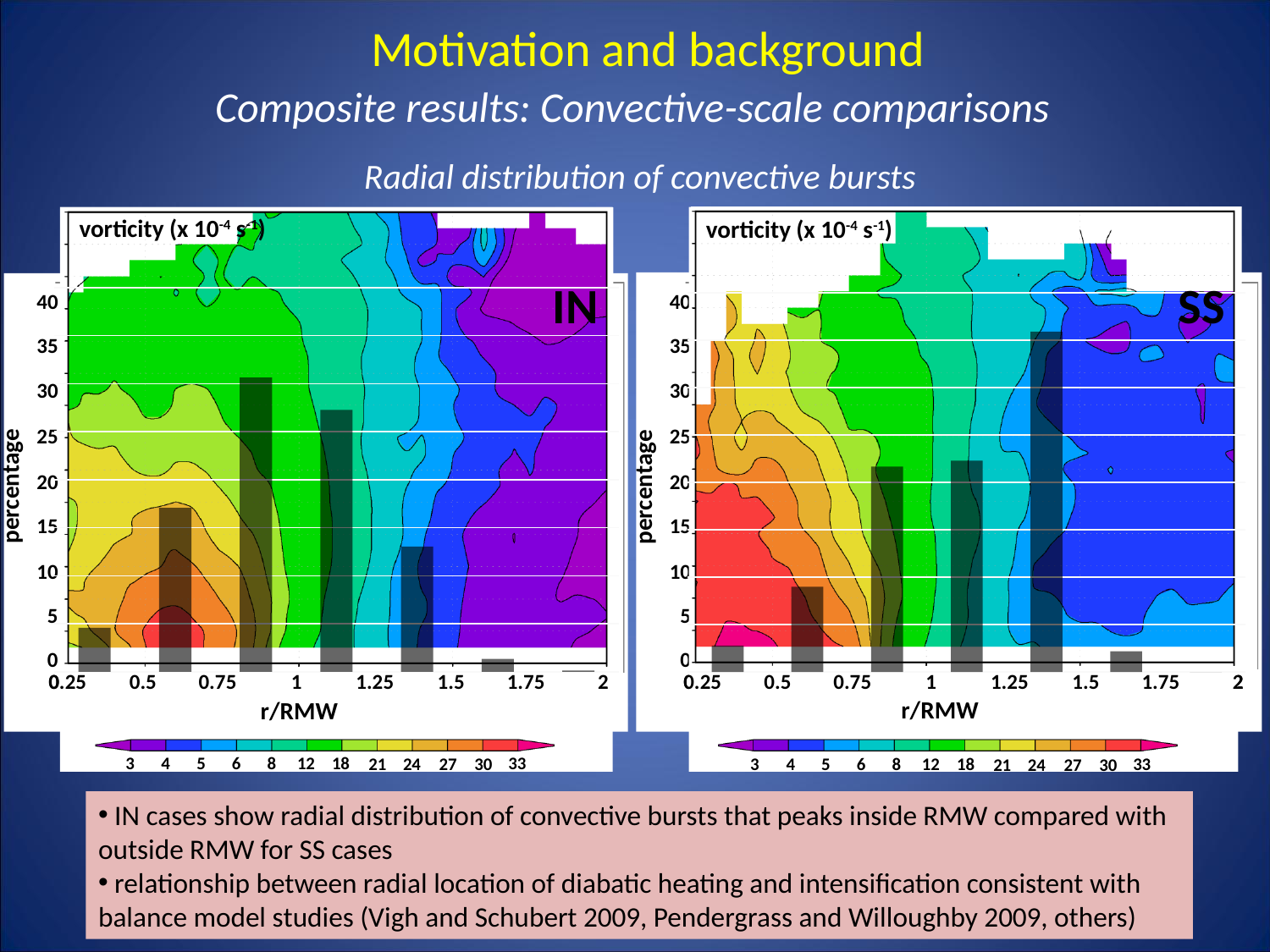
In the IN chart (left), which r/RMW interval contains the shortest bar? between 1.5 and 1.75 In the SS chart (right), is the bar between 0.5 and 0.75 r/RMW greater or less than 10 percent? less In the SS chart (right), which bar is taller: the one between 0.75 and 1 r/RMW or the one between 1.25 and 1.5 r/RMW? between 1.25 and 1.5 In the SS chart (right), which r/RMW interval contains the tallest bar? between 1.25 and 1.5 In the SS chart (right), is the bar between 1.25 and 1.5 r/RMW greater or less than 30 percent? greater In the IN chart (left), which r/RMW interval contains the tallest bar? between 0.75 and 1 What is the highest value shown on the colour bar beneath the IN chart (left)? 33 In the IN chart (left), which bar is taller: the one between 0.5 and 0.75 r/RMW or the one between 1.25 and 1.5 r/RMW? between 0.5 and 0.75 How many bars are plotted in the IN chart (left)? 6 What is the label on the y axis of the SS chart (right)? percentage In the IN chart (left), is the bar between 0.5 and 0.75 r/RMW greater or less than 20 percent? less